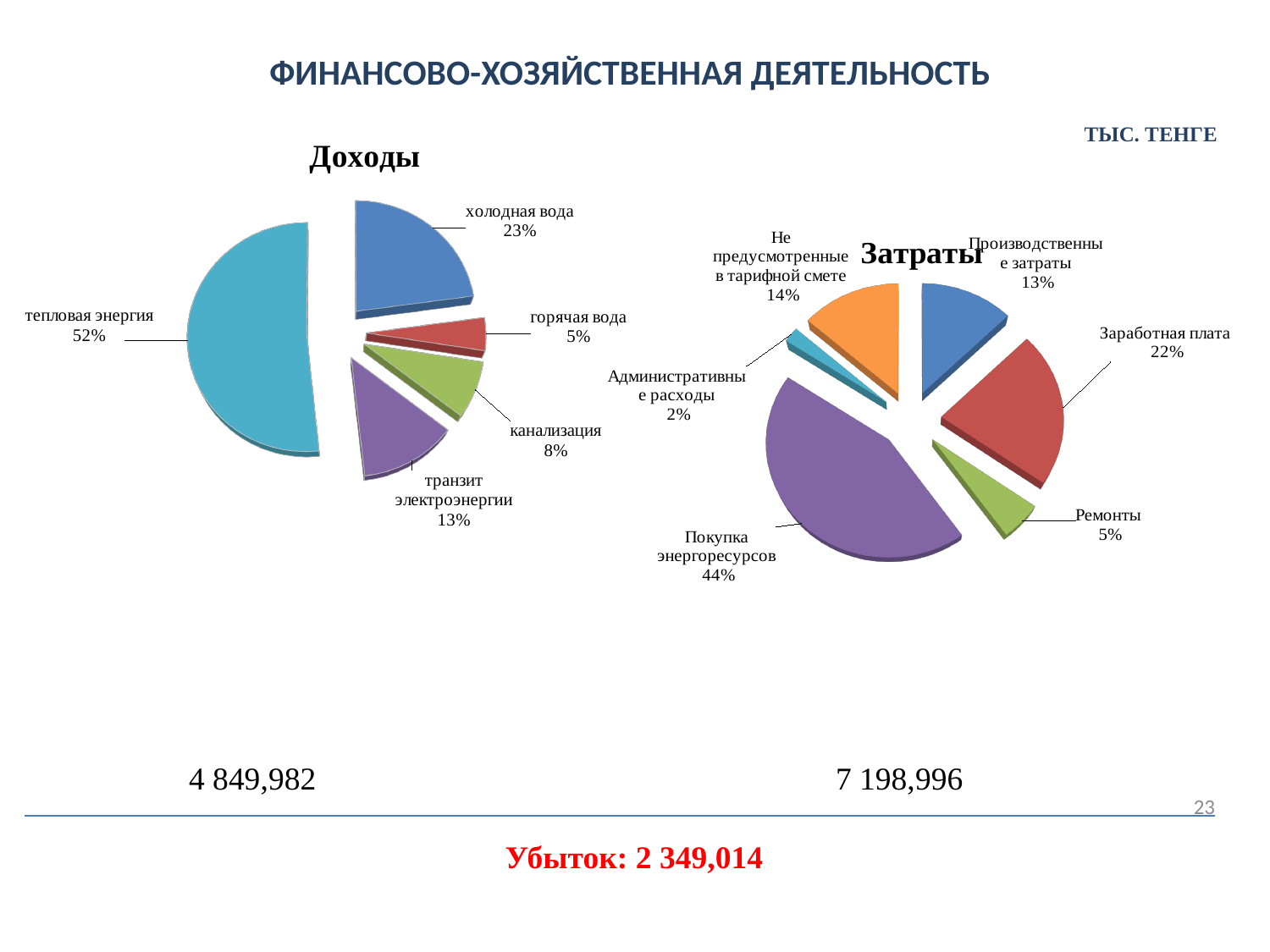
In the "Доходы" chart, how many categories are shown? 5 In the "Затраты" chart, which category has the smallest share? Административные расходы What kind of chart is the "Затраты" chart? pie chart In the "Доходы" chart, which category has the smallest share? горячая вода In the "Затраты" chart, how many categories are shown? 6 In the "Доходы" chart, what is the value for "холодная вода"? 23% In the "Доходы" chart, what share does "тепловая энергия" have? 52% What is the title of the chart on the left side of the slide? Доходы In the "Доходы" chart, what is the difference between the shares of "транзит электроэнергии" and "канализация"? 5% In the "Затраты" chart, which is larger: "Не предусмотренные в тарифной смете" or "Производственные затраты"? Не предусмотренные в тарифной смете In the "Затраты" chart, which category has the largest share? Покупка энергоресурсов In the "Затраты" chart, what is the value for "Заработная плата"? 22%